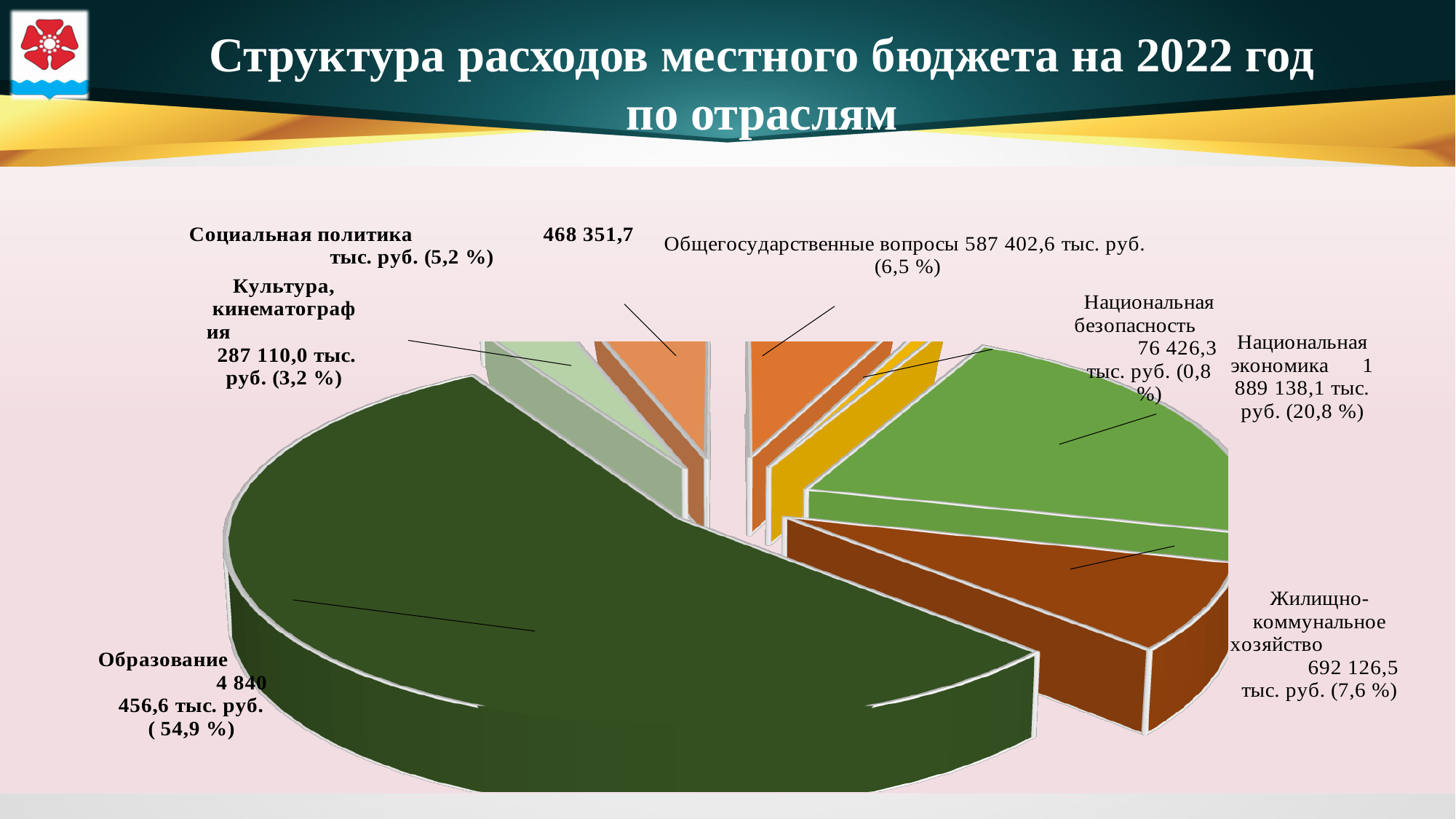
What is the value for Национальная безопасность? 76 426,3 тыс. руб. What is the title of the chart on the slide? Структура расходов местного бюджета на 2022 год по отраслям What is the value for Образование? 4 840 456,6 тыс. руб. What share of the pie does Национальная экономика represent? 20,8 % What is the difference in percentage share between Социальная политика and Культура, кинематография? 2,0 % What share of the pie does Общегосударственные вопросы represent? 6,5 % How many categories are labelled on the chart? 7 Which category has the smallest share of the pie? Национальная безопасность What kind of chart is shown on the slide? pie chart Which category has the largest share of the pie? Образование What is the value for Жилищно-коммунальное хозяйство? 692 126,5 тыс. руб. Which is larger, Социальная политика or Культура, кинематография? Социальная политика